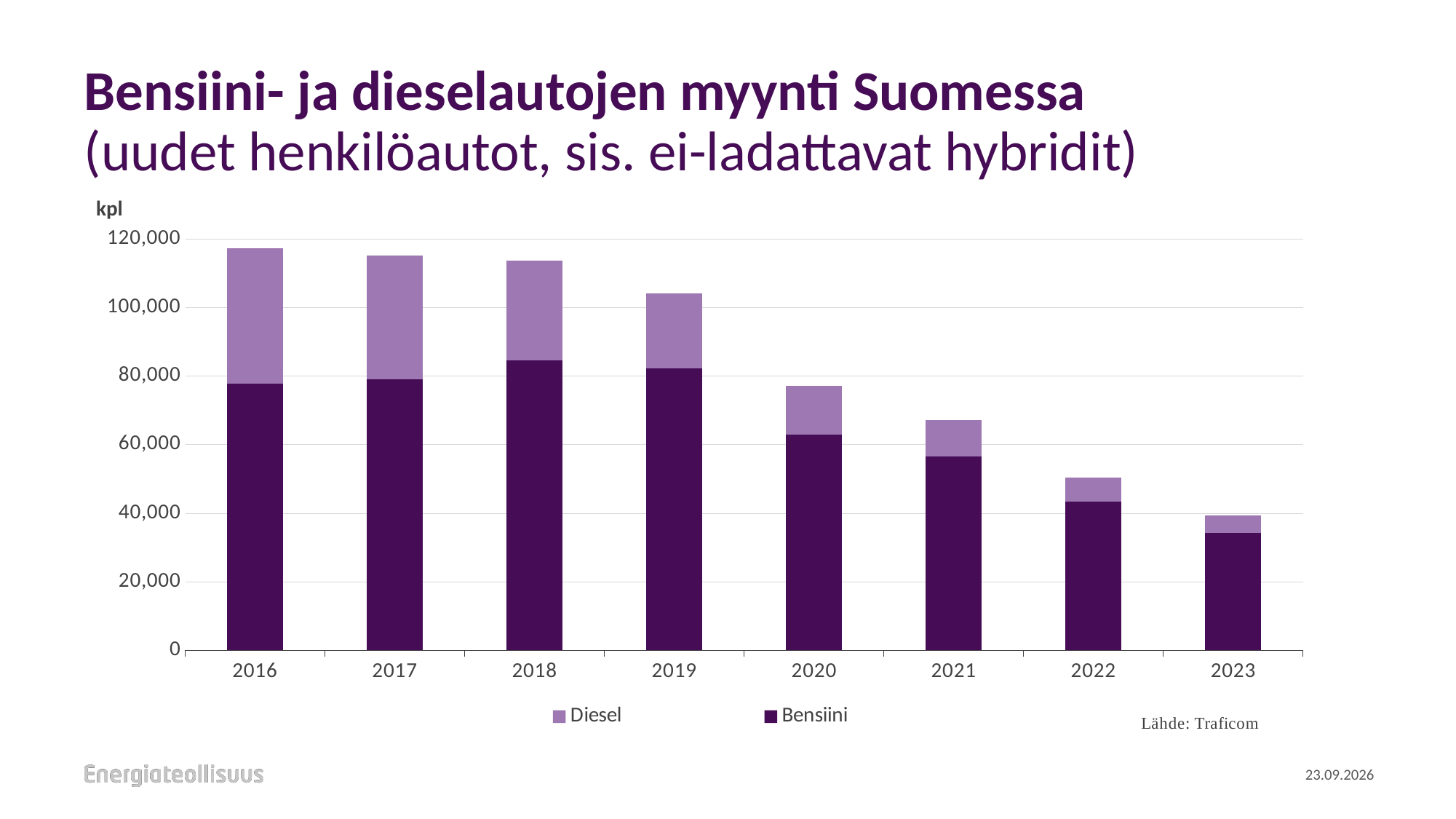
Is the total value for 2021 greater or less than 80,000? less In 2016, which series is larger, Bensiini or Diesel? Bensiini What are the two series named in the legend? Diesel and Bensiini Do the total bar heights rise or fall from 2016 to 2023? Fall Which year has the highest total bar? 2016 Which year has the lowest total bar? 2023 How many series does the legend list? 2 Is the total value for 2022 greater or less than 40,000? greater How many years are shown on the x axis? 8 Is the total value for 2016 greater or less than 100,000? greater What kind of chart is shown on the slide? Stacked bar chart What unit label is shown above the y axis? kpl